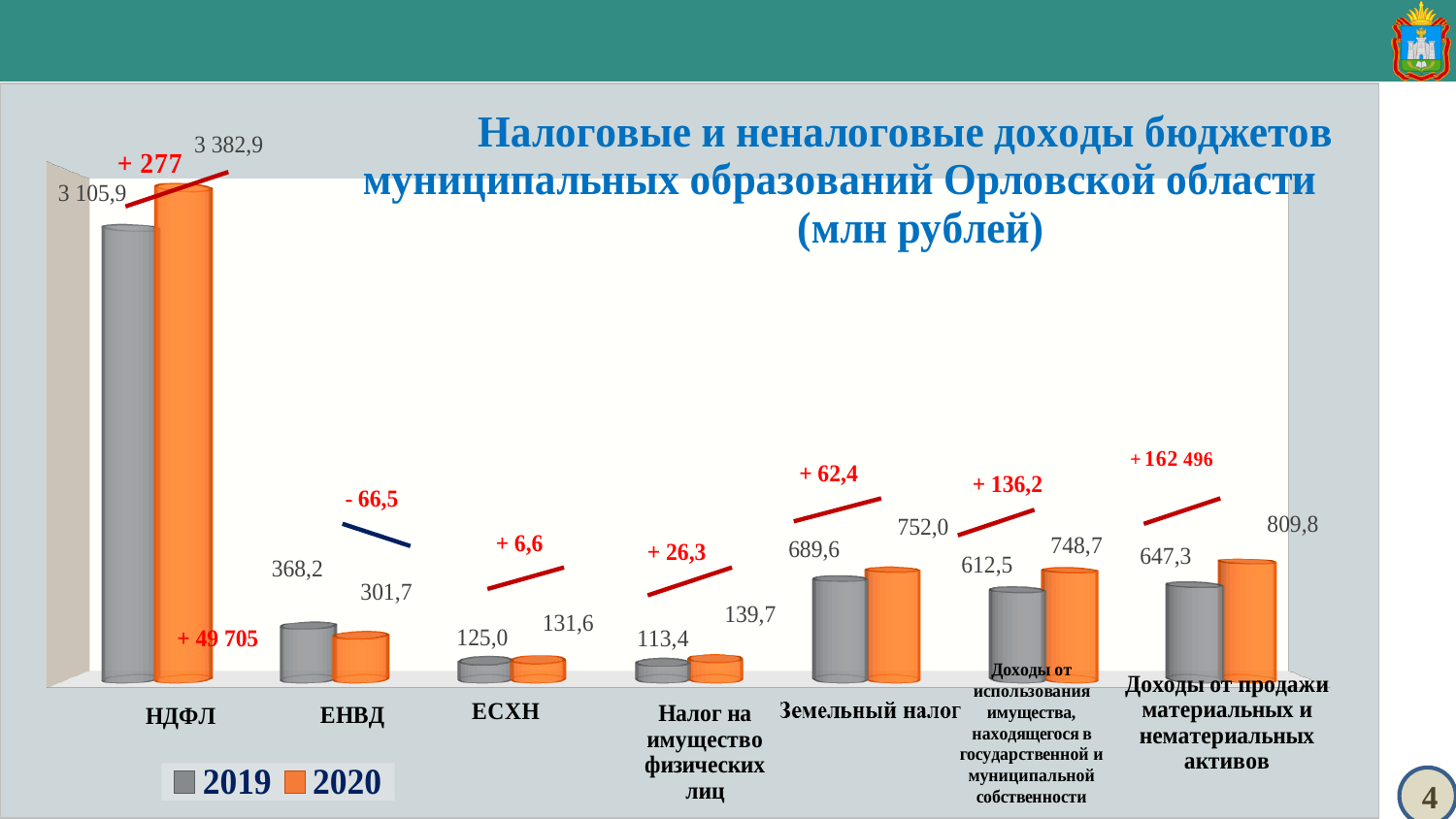
What is the value for НДФЛ in 2020? 3 382,9 What is the 2019 value for ЕСХН? 125,0 How many series does the legend list? 2 Which is larger for ЕНВД: the 2019 value or the 2020 value? 2019 Which category has the highest value in 2019? НДФЛ What is the value for ЕНВД in 2019? 368,2 Which category has the lowest value in 2020? ЕСХН What kind of chart is shown on the slide? Bar chart What is the difference between the 2020 and 2019 values for Земельный налог? 62,4 How many categories are shown on the x axis? 7 Which colour represents the 2020 series in the legend? Orange What is the 2020 value for Земельный налог? 752,0